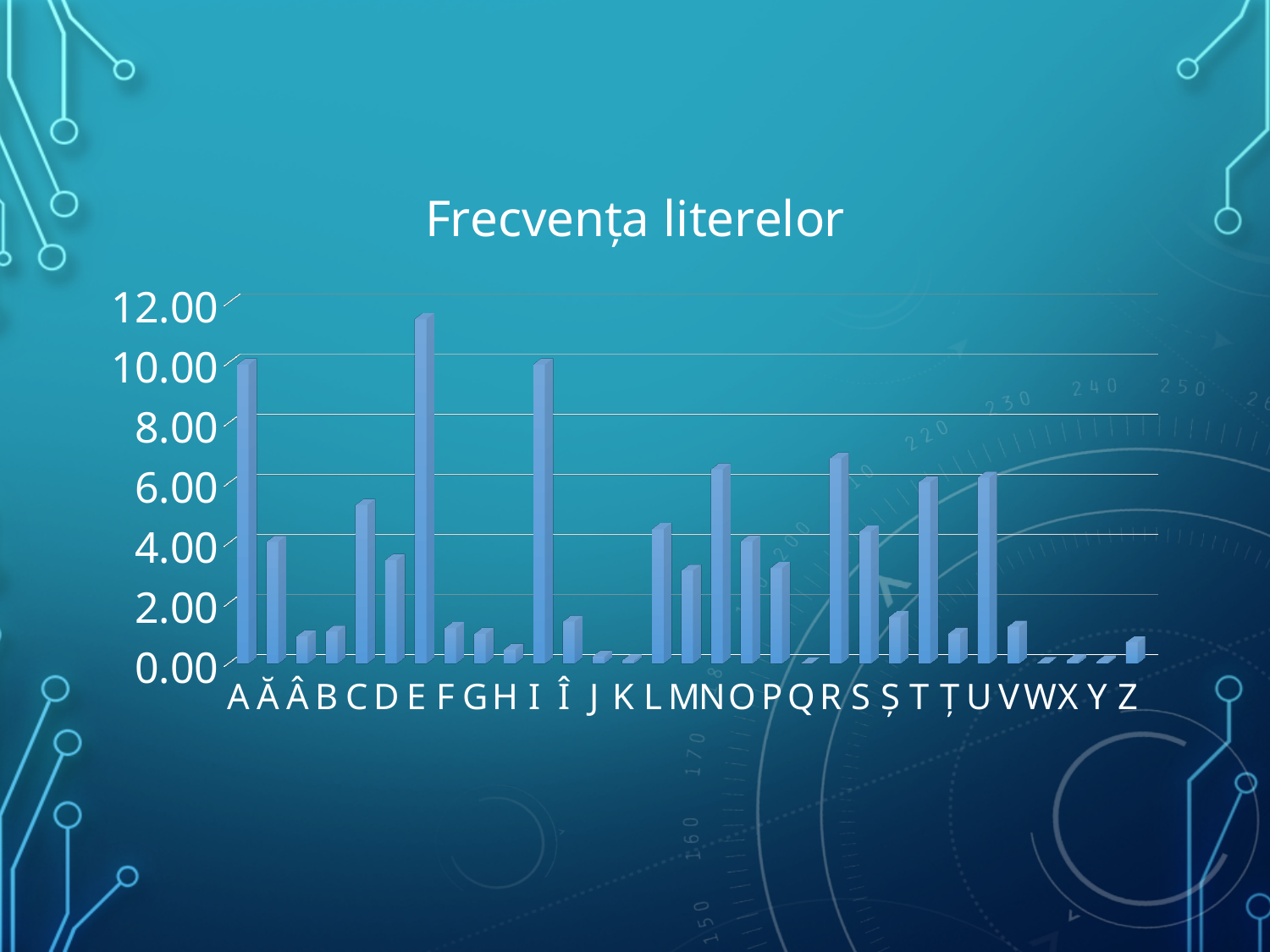
Which has a larger value, N or M? N What is the title of the chart? Frecvența literelor Which has a larger value, C or D? C Is the value for E greater or less than 10.00? greater How many letter categories are shown on the x axis? 31 Is the value for R greater or less than 6.00? greater Which has a larger value, E or A? E What is the highest value shown on the vertical axis? 12.00 Is the value for H greater or less than 2.00? less What kind of chart is shown on the slide? bar chart Which letter has the highest frequency? E